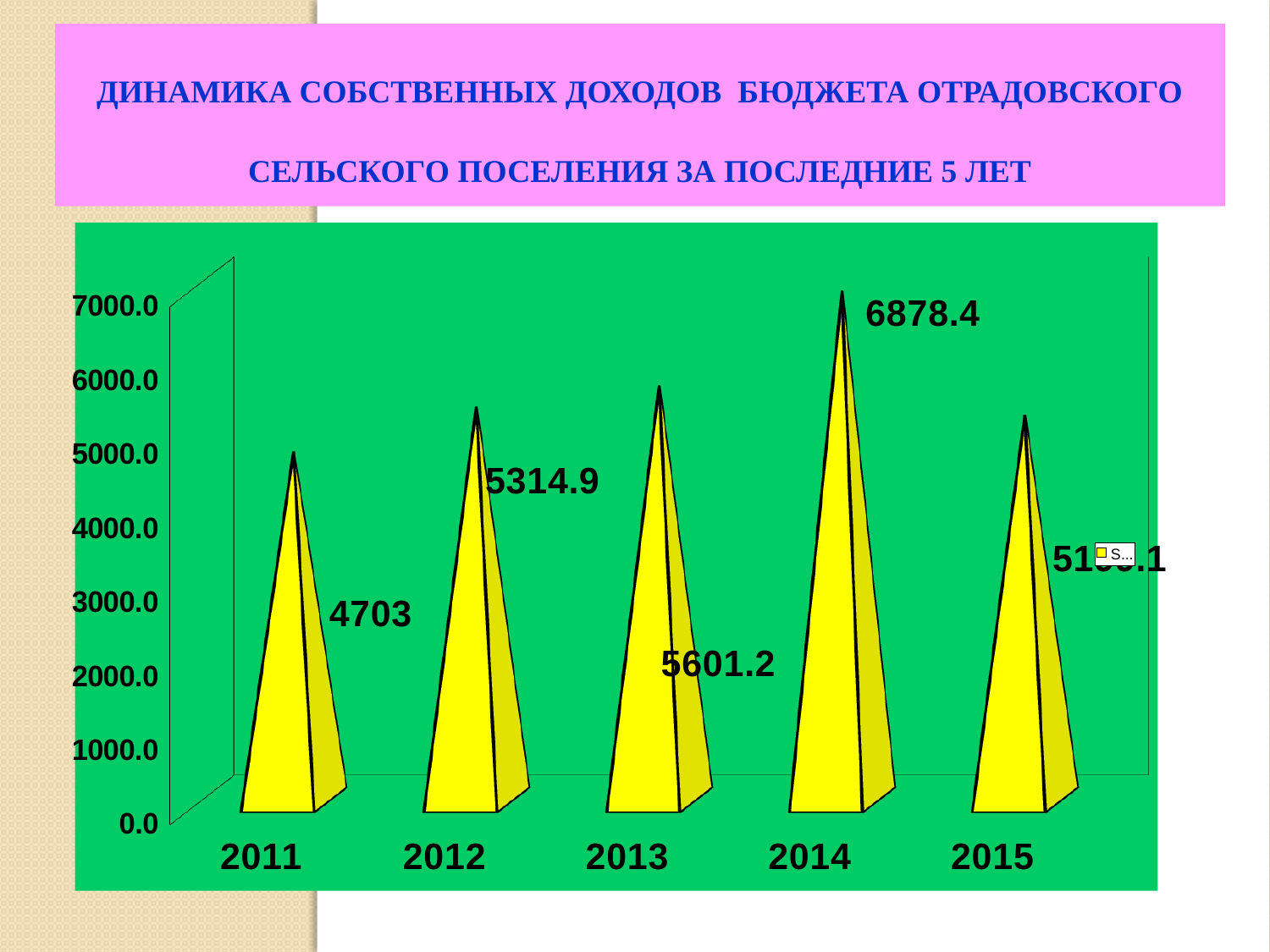
Is the value for 2015 greater or less than 5000.0? greater What is the value for 2013? 5601.2 Which year has the lowest value? 2011 What is the difference between the values for 2014 and 2011? 2175.4 What is the value for 2014? 6878.4 What is the value for 2011? 4703 Do the values rise or fall from 2011 to 2014? rise What is the difference between the values for 2013 and 2012? 286.3 Which year has the highest value? 2014 How many years are shown on the x axis? 5 What is the value for 2012? 5314.9 Which is larger, the value for 2013 or the value for 2012? 2013